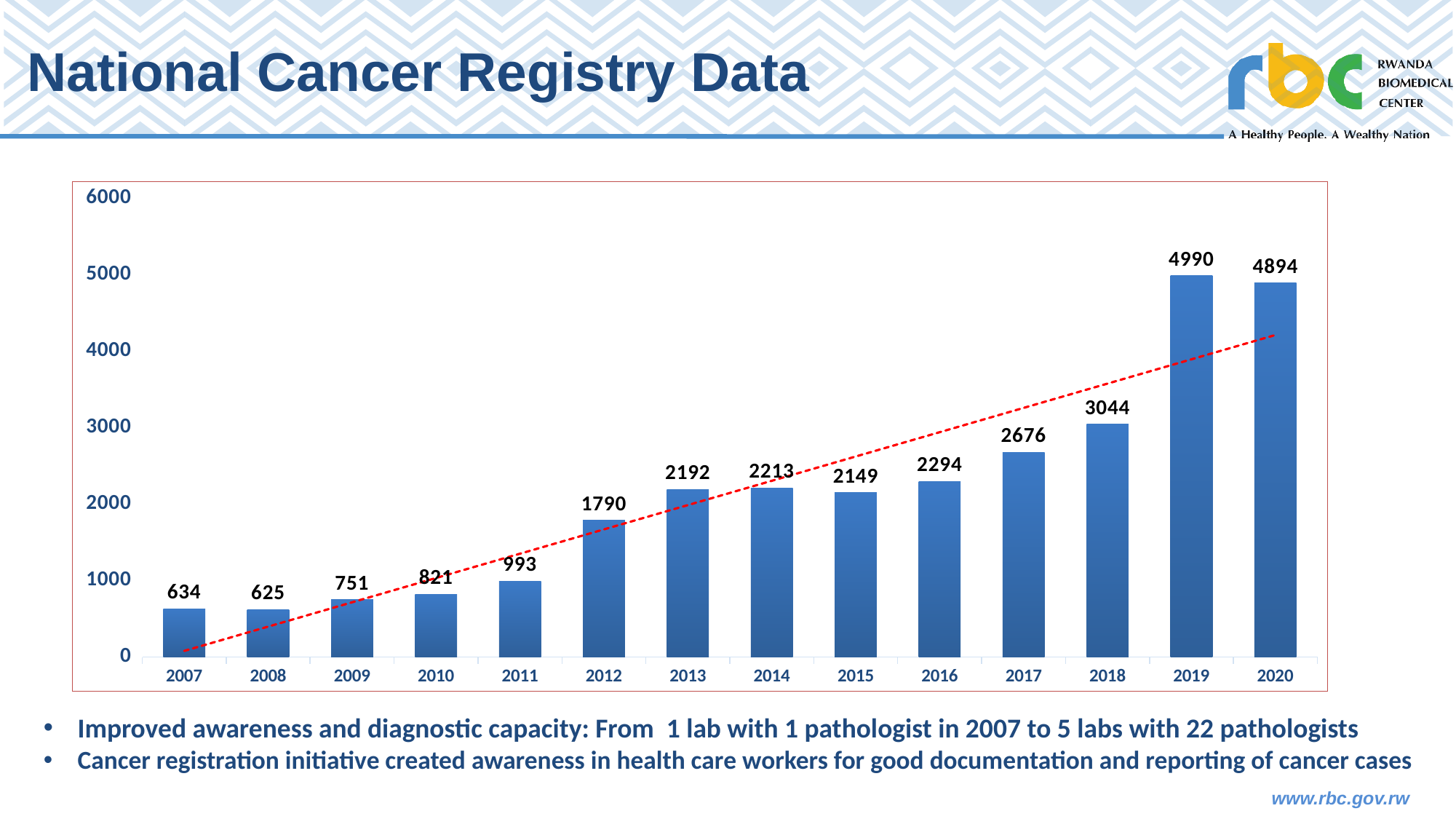
What is the value for 2012? 1790 Do the values generally rise or fall from 2007 to 2020? rise What kind of chart is shown on the slide? bar chart Which year has the lowest value? 2008 Is the value for 2011 greater or less than 1000? less What is the difference between the values for 2019 and 2020? 96 How many years are shown on the x axis? 14 Which year has the highest value? 2019 What is the difference between the values for 2018 and 2017? 368 Which is larger, the value for 2013 or the value for 2015? 2013 What is the value for 2007? 634 What is the value for 2018? 3044